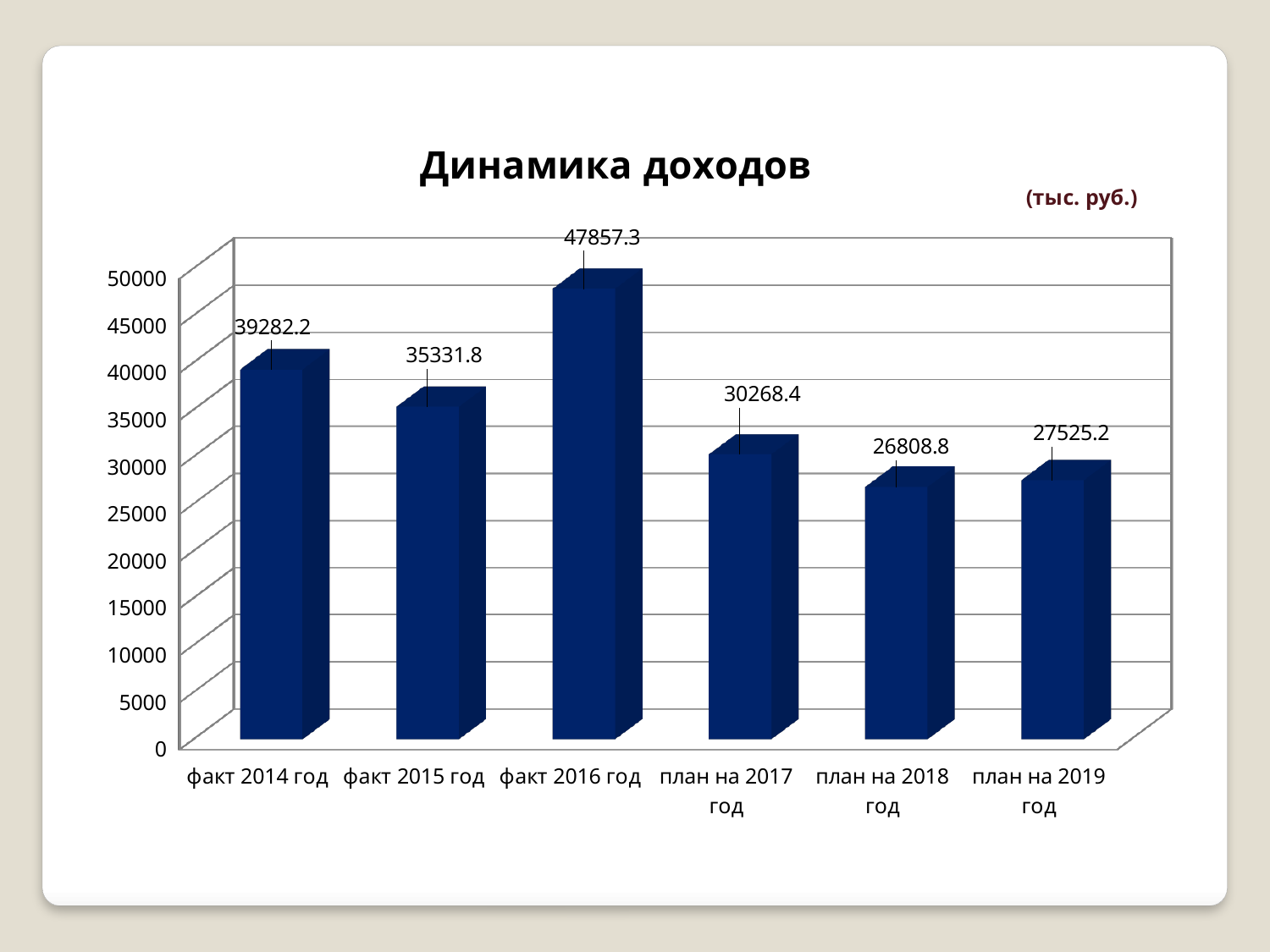
How many categories are shown on the x axis? 6 Is the value for план на 2017 год greater or less than 35000? less What is the difference between план на 2019 год and план на 2018 год? 716.4 What is the difference between факт 2016 год and факт 2015 год? 12525.5 What is the value for план на 2018 год? 26808.8 Which is larger, факт 2015 год or план на 2017 год? факт 2015 год Which category has the lowest value? план на 2018 год Which category has the highest value? факт 2016 год What is the title of the chart? Динамика доходов What is the value for факт 2016 год? 47857.3 What is the value for факт 2014 год? 39282.2 What kind of chart is this? bar chart